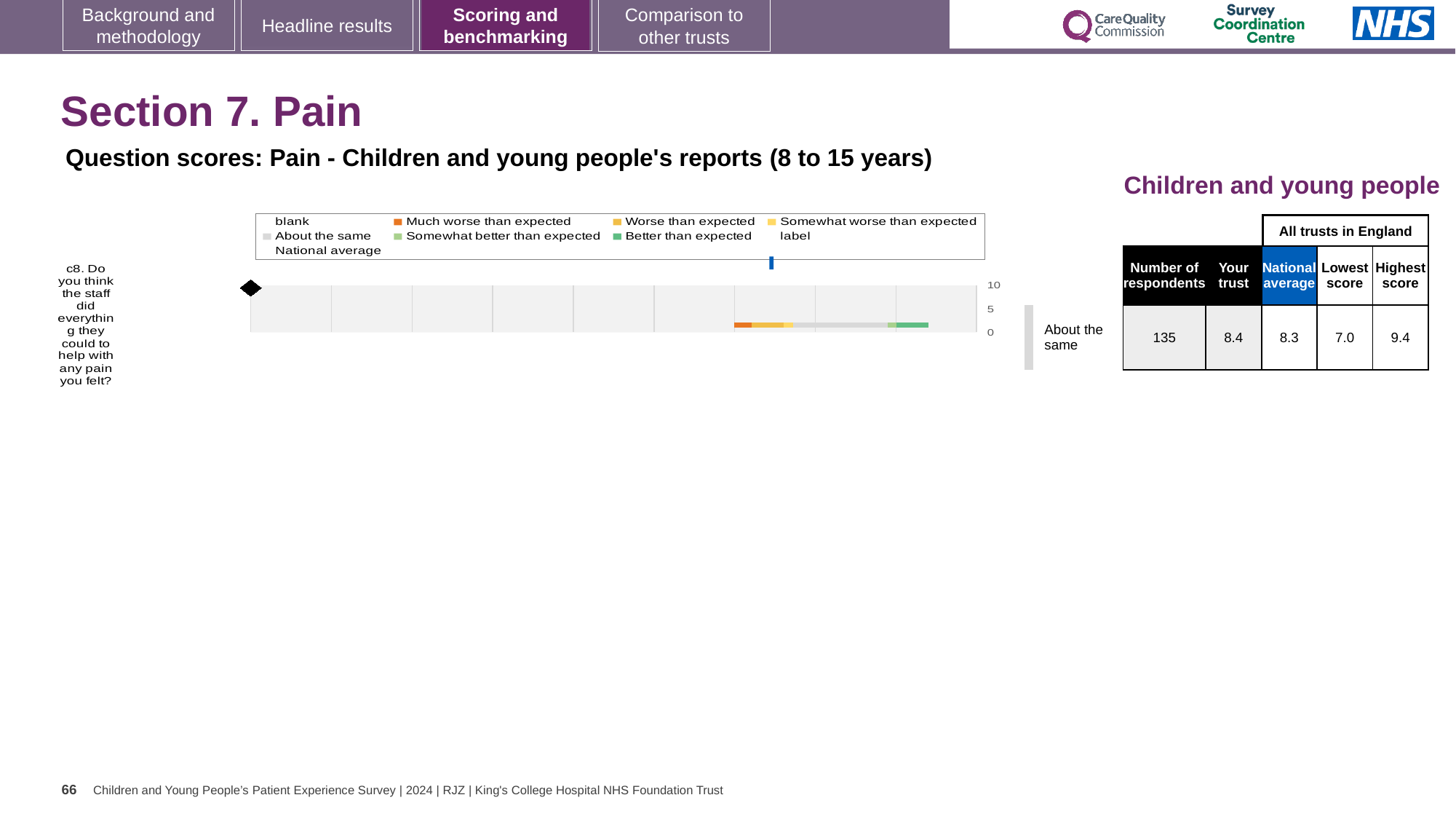
What colour does the legend use for 'Much worse than expected'? orange In the table beside the chart, what is the national average for question c8? 8.3 In the table beside the chart, how many respondents answered question c8? 135 In the table beside the chart, what is the difference between the highest score and the lowest score for question c8? 2.4 In the table beside the chart, is the 'Your trust' score or the national average larger for question c8? Your trust How many question categories are plotted on the chart? 1 What benchmark category label is shown next to the chart for question c8? About the same In the table beside the chart, what is the 'Your trust' score for question c8? 8.4 What kind of chart is shown on the slide? bar chart How many entries does the chart legend list? 9 What is the highest tick value shown on the chart's numeric axis? 10 Which question is plotted on the chart? c8. Do you think the staff did everything they could to help with any pain you felt?